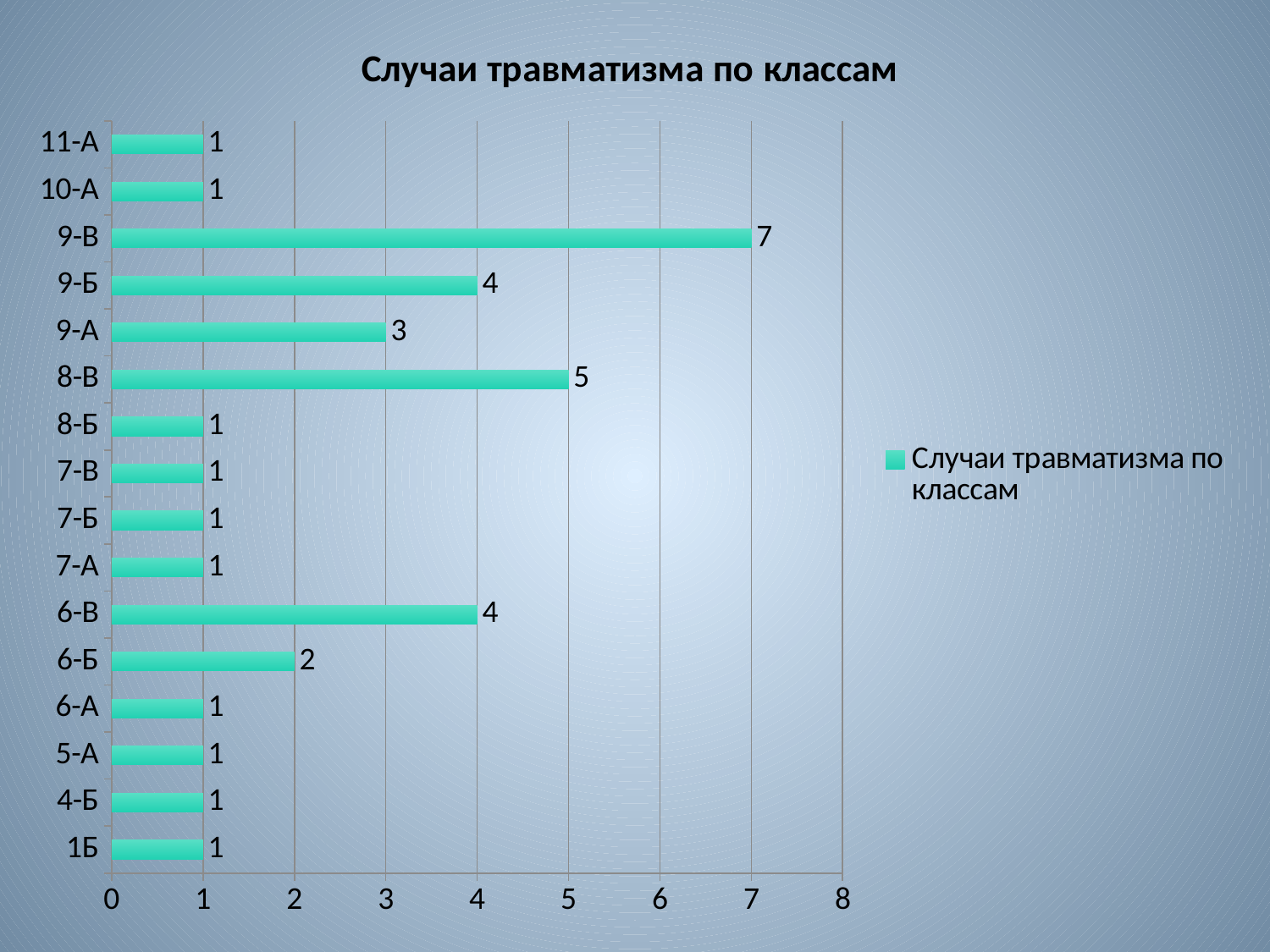
What is the value for 8-В? 5 Which is larger, the value for 6-В or the value for 9-А? 6-В What is the value for 9-В? 7 What is the value for 6-Б? 2 What is the title of the chart? Случаи травматизма по классам What is the difference between the values for 9-В and 8-В? 2 What is the value for 9-А? 3 What kind of chart is shown on the slide? Bar chart What is the difference between the values for 9-Б and 6-Б? 2 How many classes are shown on the chart? 16 Which class has the highest value? 9-В How many series does the legend list? 1